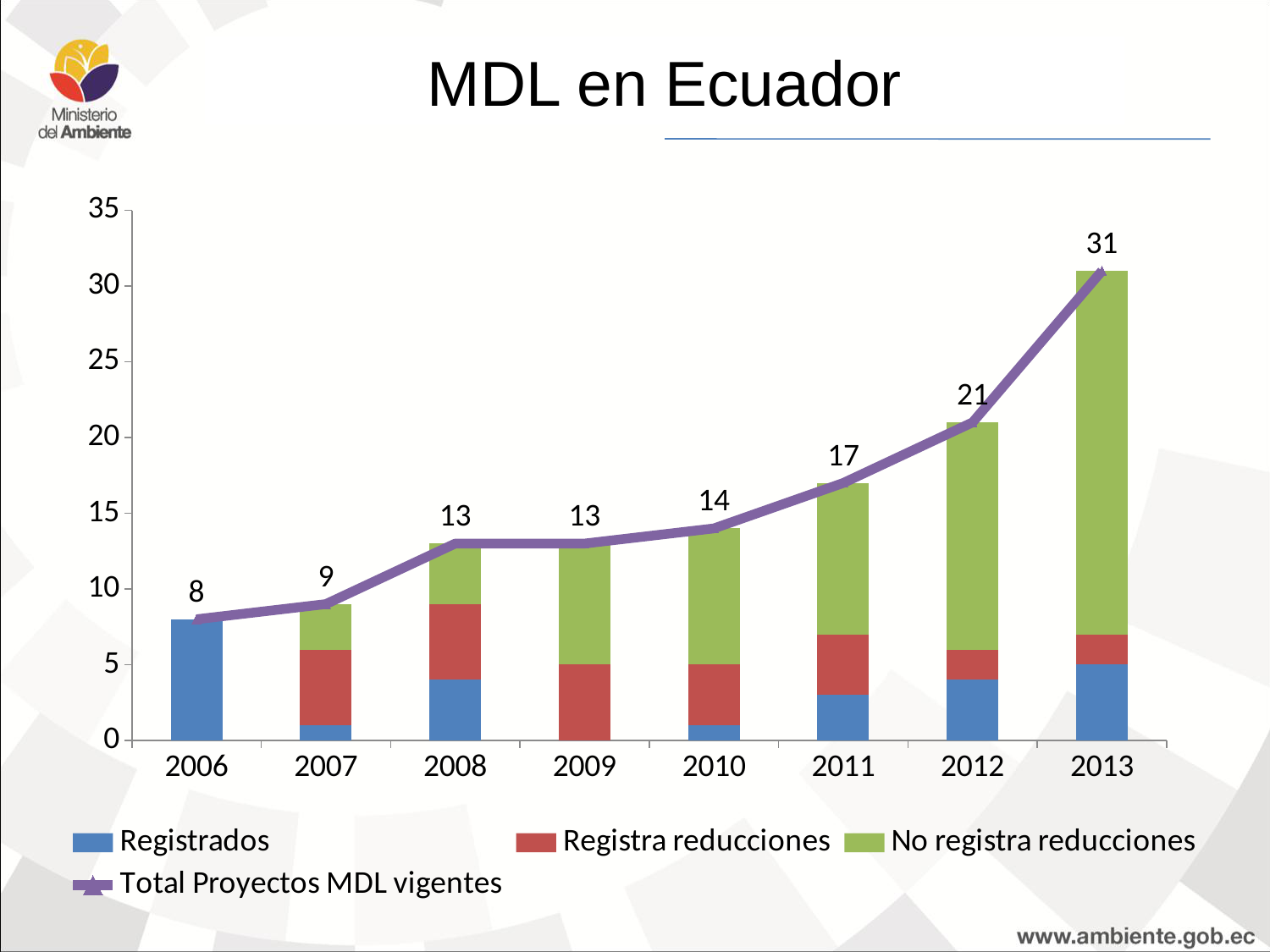
How many series does the legend list? 4 Is the Registrados value for 2013 greater or less than 10? less What is the difference between the Total Proyectos MDL vigentes values for 2013 and 2012? 10 Which year has the highest value for Total Proyectos MDL vigentes? 2013 What is the title of the slide containing the chart? MDL en Ecuador What is the value of Total Proyectos MDL vigentes for 2013? 31 Which is larger, the Total Proyectos MDL vigentes value for 2011 or for 2009? 2011 Which year has the lowest value for Total Proyectos MDL vigentes? 2006 How many years are shown on the x axis? 8 What is the value of Total Proyectos MDL vigentes for 2010? 14 Does the Total Proyectos MDL vigentes line generally rise or fall from 2006 to 2013? rise What is the value of Total Proyectos MDL vigentes for 2006? 8